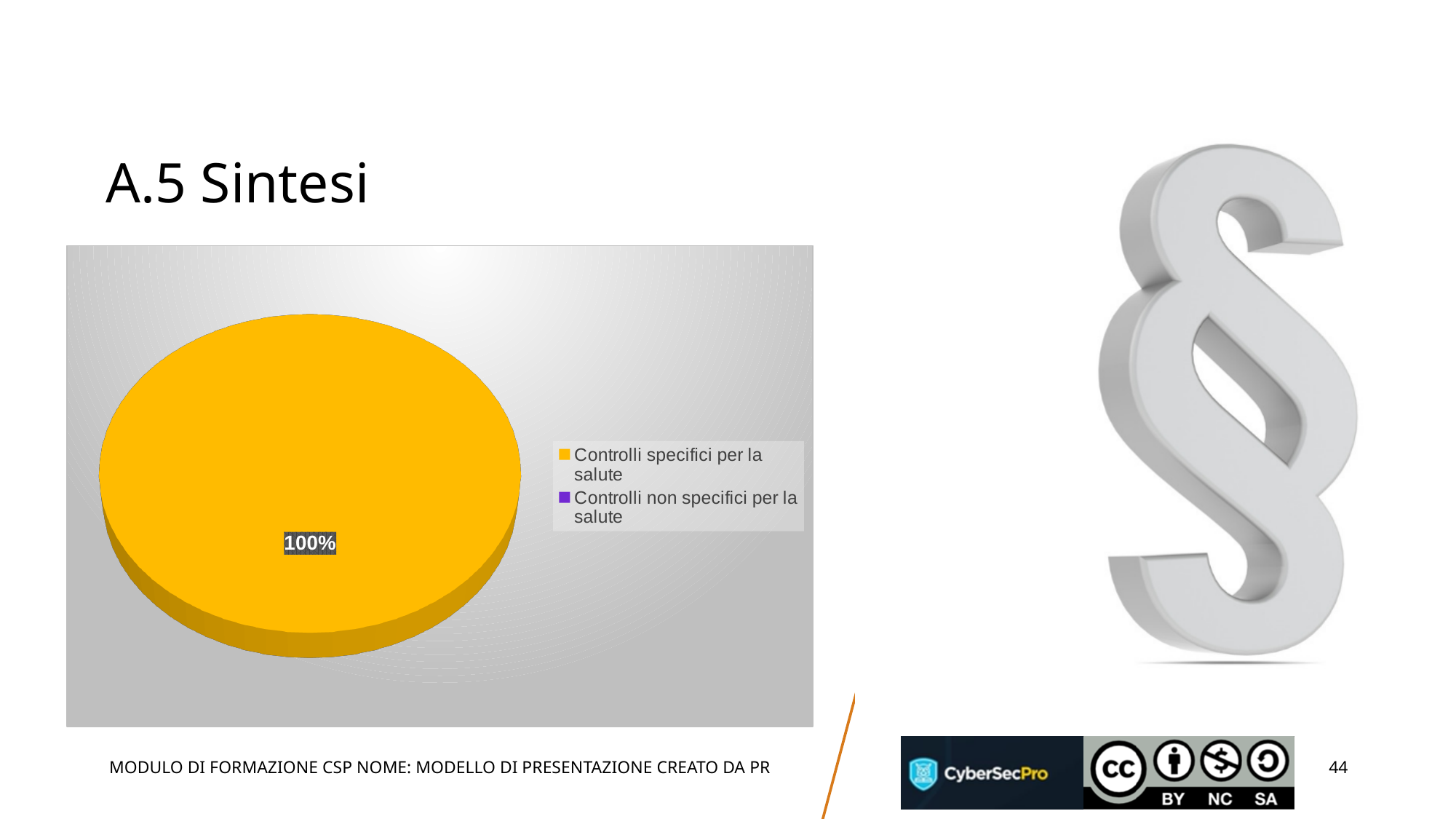
What kind of chart is shown on the slide? pie chart How many entries does the chart's legend list? 2 What colour represents Controlli non specifici per la salute in the legend? purple Which category has the largest share of the pie? Controlli specifici per la salute Which is larger: the share for Controlli specifici per la salute or the share for Controlli non specifici per la salute? Controlli specifici per la salute What share of the pie does the slice labelled on the chart represent? 100% Which category has the smallest share of the pie? Controlli non specifici per la salute Which legend category does the slice labelled 100% belong to? Controlli specifici per la salute Is the share for Controlli specifici per la salute greater or less than 50%? greater What colour represents Controlli specifici per la salute in the legend? yellow